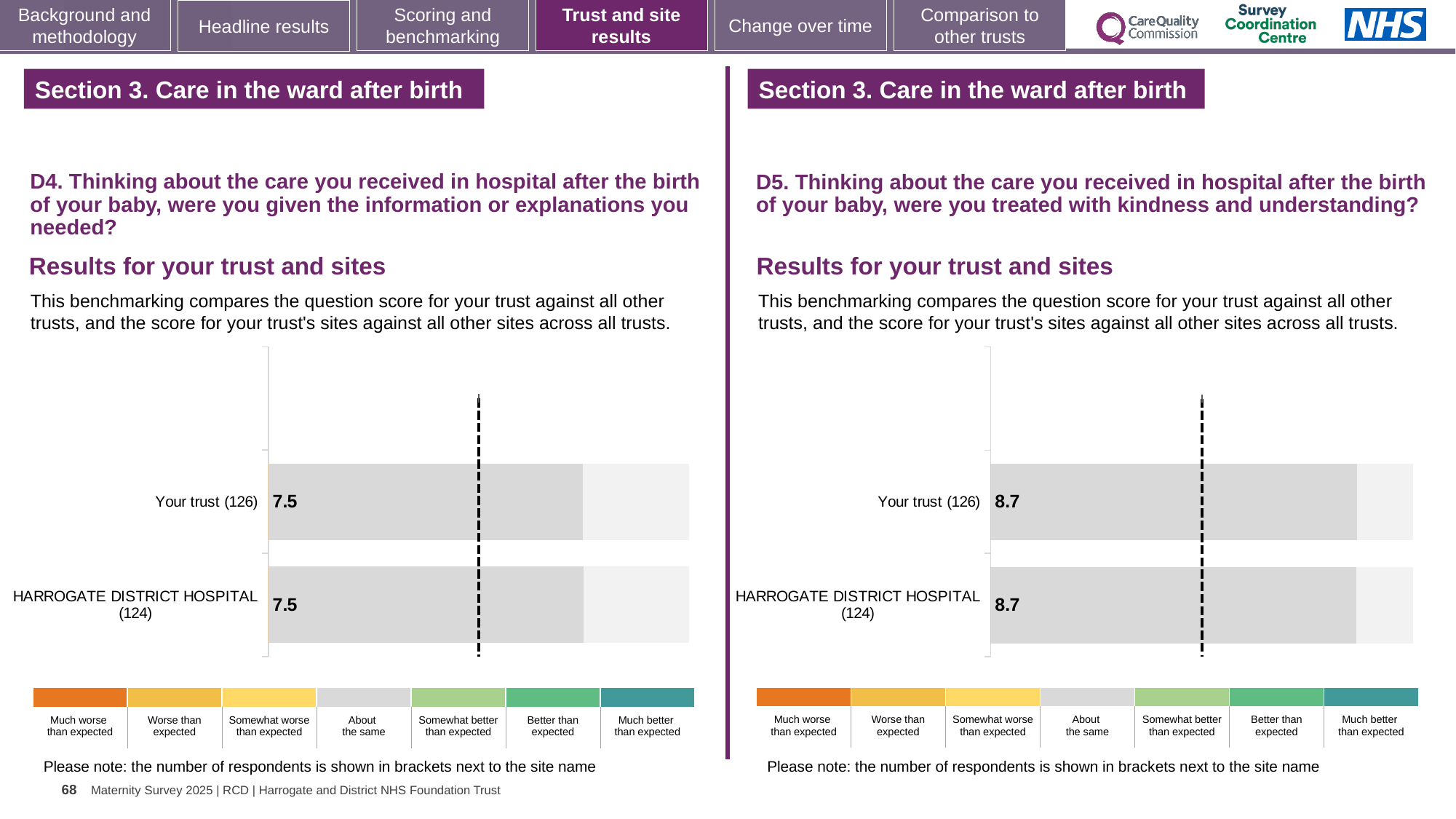
How many respondents are shown in brackets for Harrogate District Hospital on the right chart (D5)? 124 On the right chart (D5), what is the difference between the Your trust score and the Harrogate District Hospital score? 0 On the left chart (D4), what is the score for Harrogate District Hospital? 7.5 On the right chart (D5), what is the score for Your trust? 8.7 On the left chart (D4), what is the difference between the Your trust score and the Harrogate District Hospital score? 0 On the left chart (D4), what is the score for Your trust? 7.5 How many bars are plotted on the right chart (D5)? 2 What type of chart is used on the left (D4)? Bar chart How many categories does the colour key below the left chart (D4) list? 7 Which category in the colour key below the right chart (D5) is shown in dark orange? Much worse than expected How many bars are plotted on the left chart (D4)? 2 On the right chart (D5), what is the score for Harrogate District Hospital? 8.7